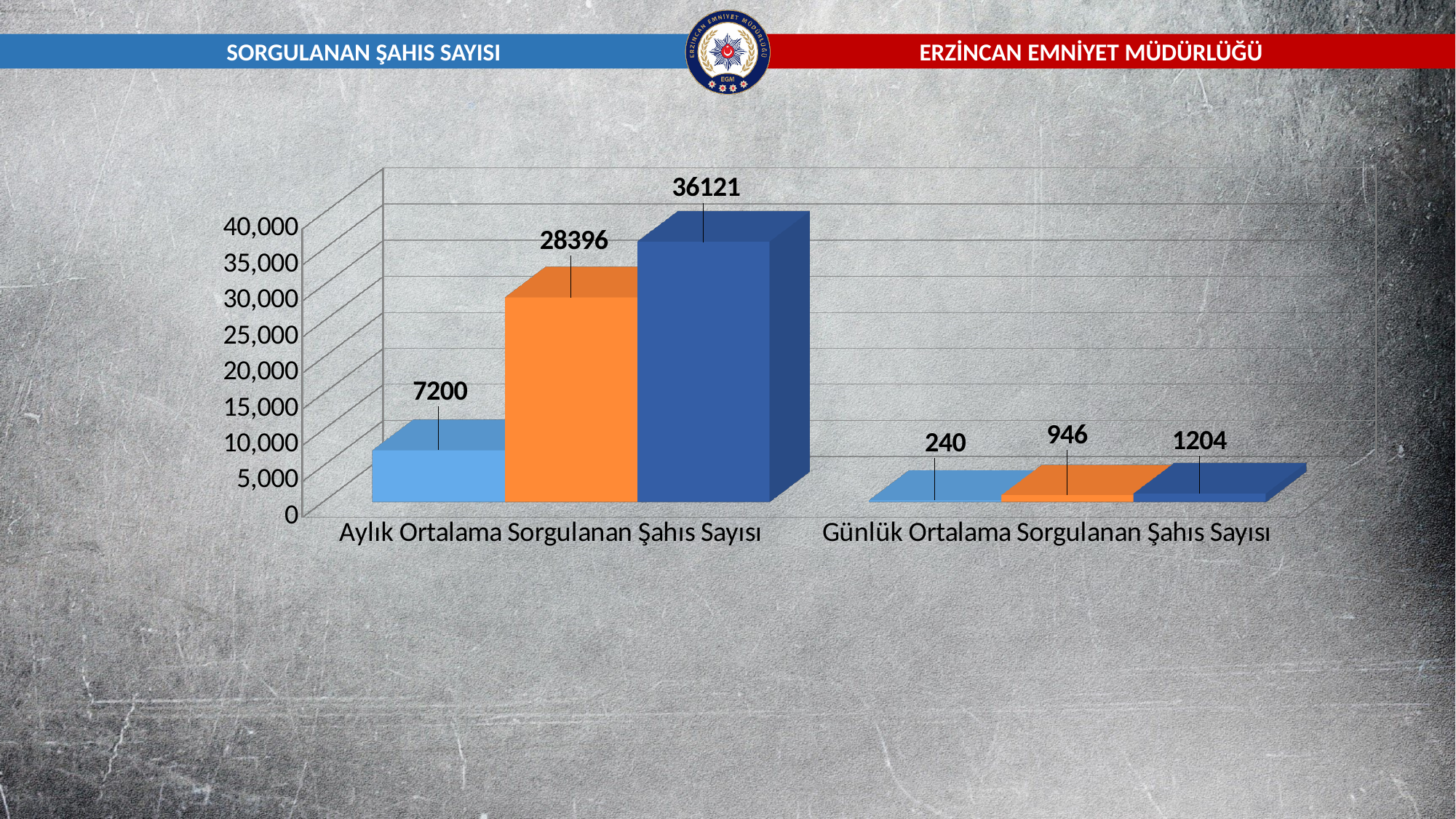
Which bar has the highest value in the chart? The dark blue bar for Aylık Ortalama Sorgulanan Şahıs Sayısı (36121) What is the value of the dark blue bar for Aylık Ortalama Sorgulanan Şahıs Sayısı? 36121 What kind of chart is shown on the slide? Bar chart What is the value of the orange bar for Aylık Ortalama Sorgulanan Şahıs Sayısı? 28396 What is the difference between the orange and light blue bars for Günlük Ortalama Sorgulanan Şahıs Sayısı? 706 How many categories are shown on the x axis of the chart? 2 What is the value of the light blue bar for Aylık Ortalama Sorgulanan Şahıs Sayısı? 7200 Which bar has the lowest value in the chart? The light blue bar for Günlük Ortalama Sorgulanan Şahıs Sayısı (240) What is the value of the dark blue bar for Günlük Ortalama Sorgulanan Şahıs Sayısı? 1204 Which is larger: the orange bar for Aylık Ortalama Sorgulanan Şahıs Sayısı or the light blue bar for Aylık Ortalama Sorgulanan Şahıs Sayısı? The orange bar (28396) What is the value of the light blue bar for Günlük Ortalama Sorgulanan Şahıs Sayısı? 240 What is the difference between the dark blue and orange bars for Aylık Ortalama Sorgulanan Şahıs Sayısı? 7725